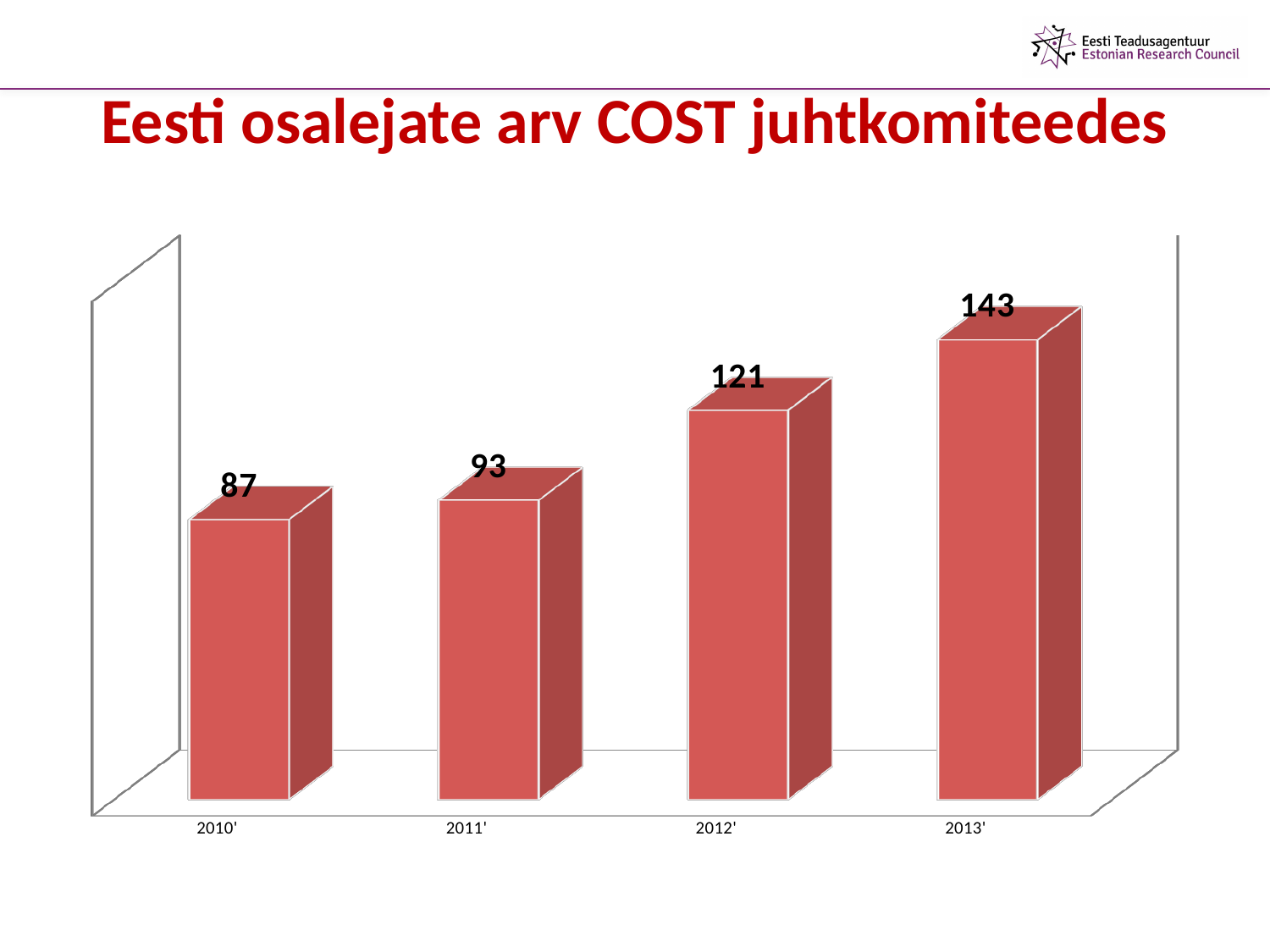
What is the value for 2010'? 87 What is the value for 2012'? 121 What is the value for 2011'? 93 What is the value for 2013'? 143 Which is larger, the value for 2011' or the value for 2012'? 2012' What kind of chart is shown on the slide? bar chart Which year has the highest value? 2013' Which year has the lowest value? 2010' How many years are shown on the chart? 4 What is the difference between the values for 2012' and 2011'? 28 What is the difference between the values for 2013' and 2010'? 56 Do the values rise or fall from 2010' to 2013'? rise